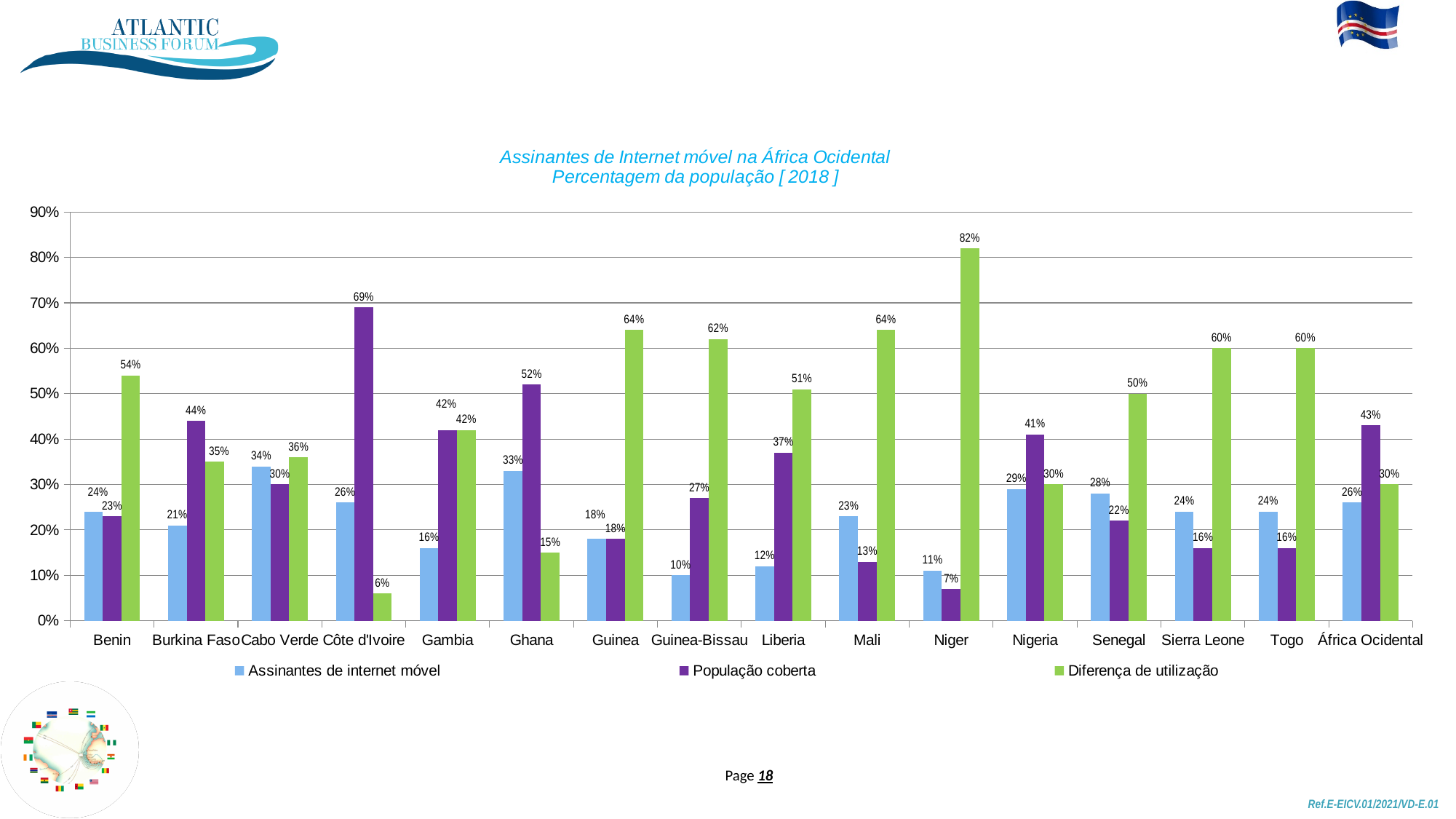
Which is larger for Senegal: Assinantes de internet móvel or População coberta? Assinantes de internet móvel Which category has the lowest value for Diferença de utilização? Côte d'Ivoire What is the difference between População coberta and Assinantes de internet móvel for Ghana? 19% What is the value of Diferença de utilização for Niger? 82% What is the value of Assinantes de internet móvel for África Ocidental? 26% Which category has the lowest value for População coberta? Niger How many series does the legend list? 3 Which country has the highest value for Assinantes de internet móvel? Cabo Verde What is the value of População coberta for Côte d'Ivoire? 69% What kind of chart is shown on the slide? Bar chart What is the value of Assinantes de internet móvel for Cabo Verde? 34% How many countries or regions are shown on the x axis? 16